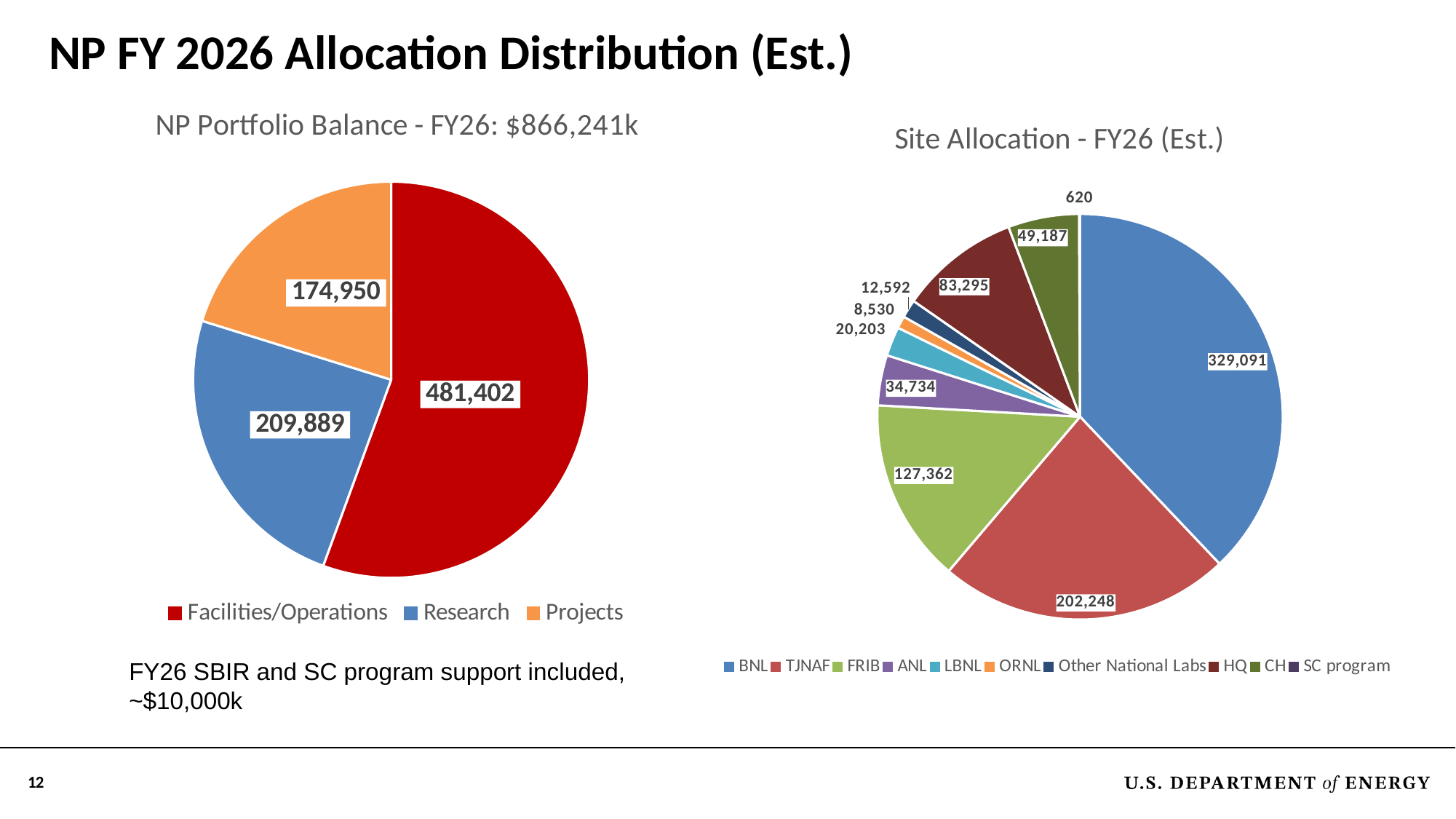
In the 'NP Portfolio Balance - FY26' chart, how many categories does the legend list? 3 In the 'Site Allocation - FY26 (Est.)' chart, which is larger, FRIB or ANL? FRIB What type of chart is the 'NP Portfolio Balance - FY26' chart? pie chart In the 'Site Allocation - FY26 (Est.)' chart, what is the value for BNL? 329,091 In the 'NP Portfolio Balance - FY26' chart, what is the value for Projects? 174,950 In the 'Site Allocation - FY26 (Est.)' chart, what is the difference between BNL and TJNAF? 126,843 How many categories are shown in the 'Site Allocation - FY26 (Est.)' chart? 10 In the 'Site Allocation - FY26 (Est.)' chart, what is the value for HQ? 83,295 In the 'Site Allocation - FY26 (Est.)' chart, which site has the smallest slice? SC program In the 'NP Portfolio Balance - FY26' chart, what is the value for Research? 209,889 In the 'NP Portfolio Balance - FY26' chart, which category has the largest slice? Facilities/Operations In the 'NP Portfolio Balance - FY26' chart, what is the difference between Facilities/Operations and Research? 271,513